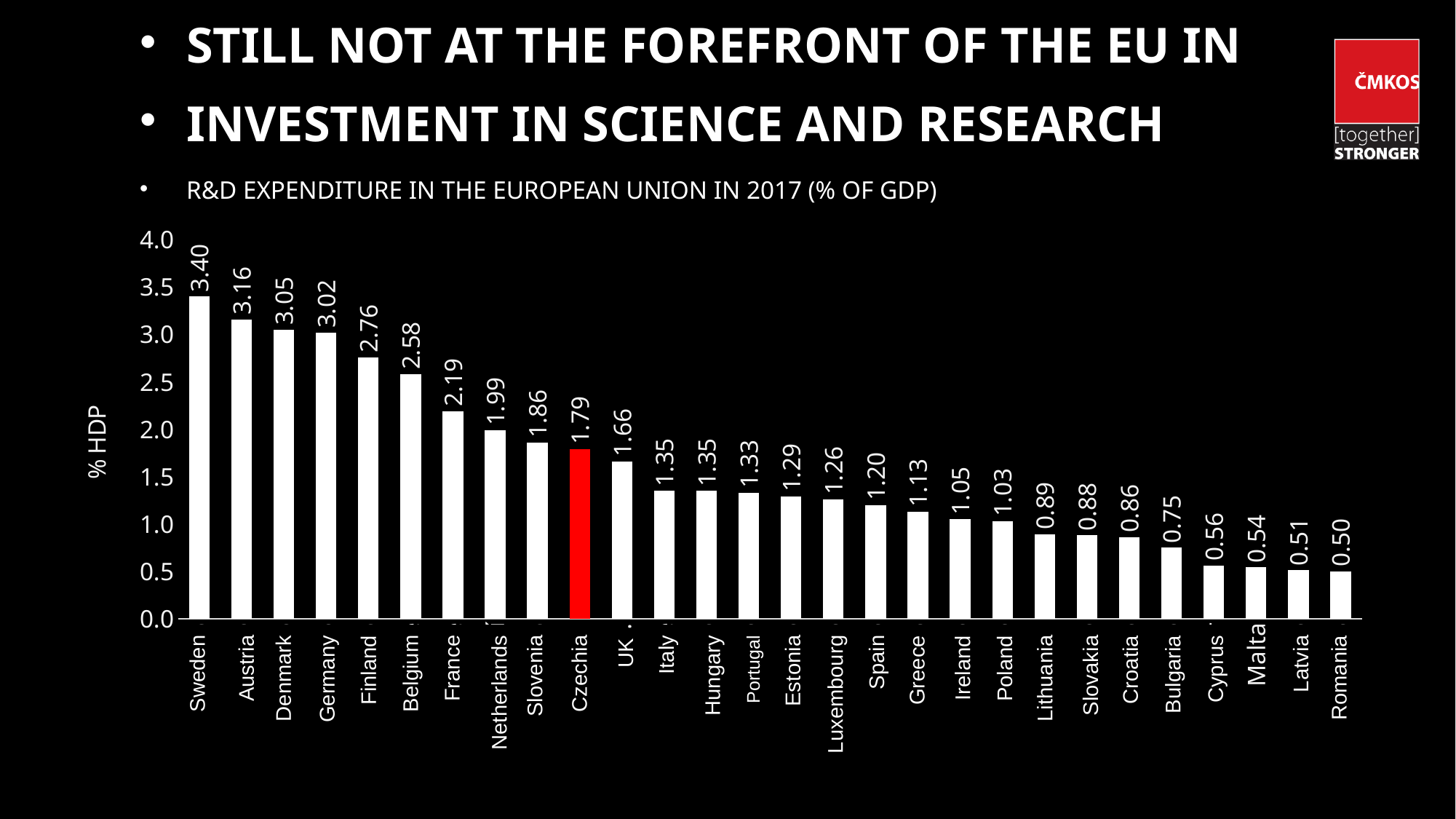
Which country's bar is highlighted in red? Czechia Is the value for Netherlands greater or less than 1.5? greater What is the value shown for Germany? 3.02 What is the difference between the values for Sweden and Czechia? 1.61 What is the difference between the values for Austria and Denmark? 0.11 Which has a higher value, Finland or France? Finland Which country has the lowest R&D expenditure in the chart? Romania How many countries are shown in the chart? 28 What is the R&D expenditure value shown for Czechia? 1.79 Which country has the highest R&D expenditure in the chart? Sweden What is the value shown for Poland? 1.03 What kind of chart is shown on the slide? Bar chart